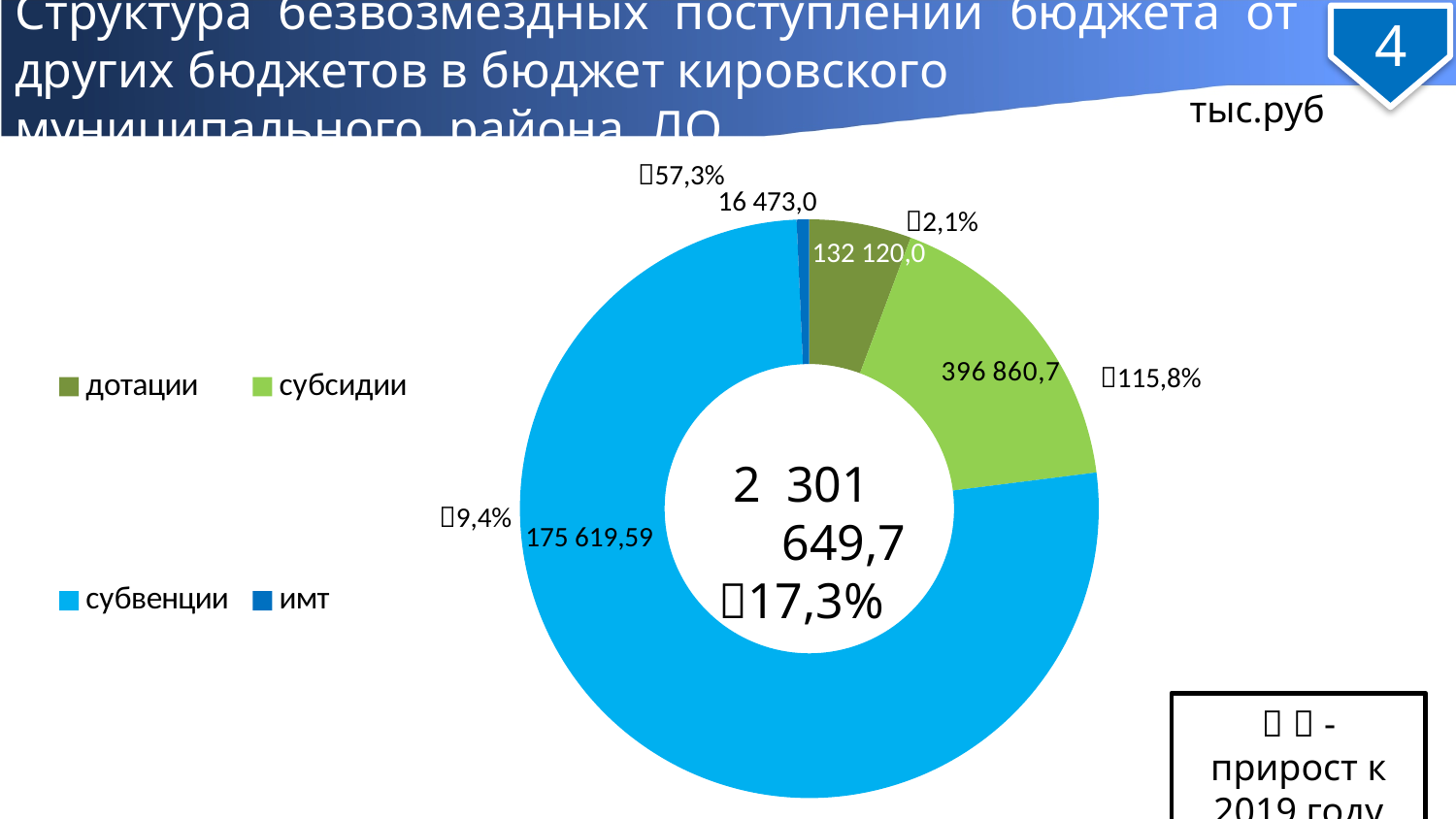
What is the difference between the value for дотации and the value for имт? 115 647,0 What is the value shown for имт? 16 473,0 Which is larger, the value for субсидии or the value for дотации? субсидии What total value is printed in the centre of the doughnut chart? 2 301 649,7 What growth percentage is printed next to the субсидии slice? 115,8% What is the difference between the value for субсидии and the value for дотации? 264 740,7 Which category has the largest slice of the chart? субвенции What is the value shown for дотации? 132 120,0 Which category has the smallest slice of the chart? имт What is the value shown for субсидии? 396 860,7 What kind of chart is shown on the slide? doughnut (pie) chart How many categories does the legend of the chart list? 4